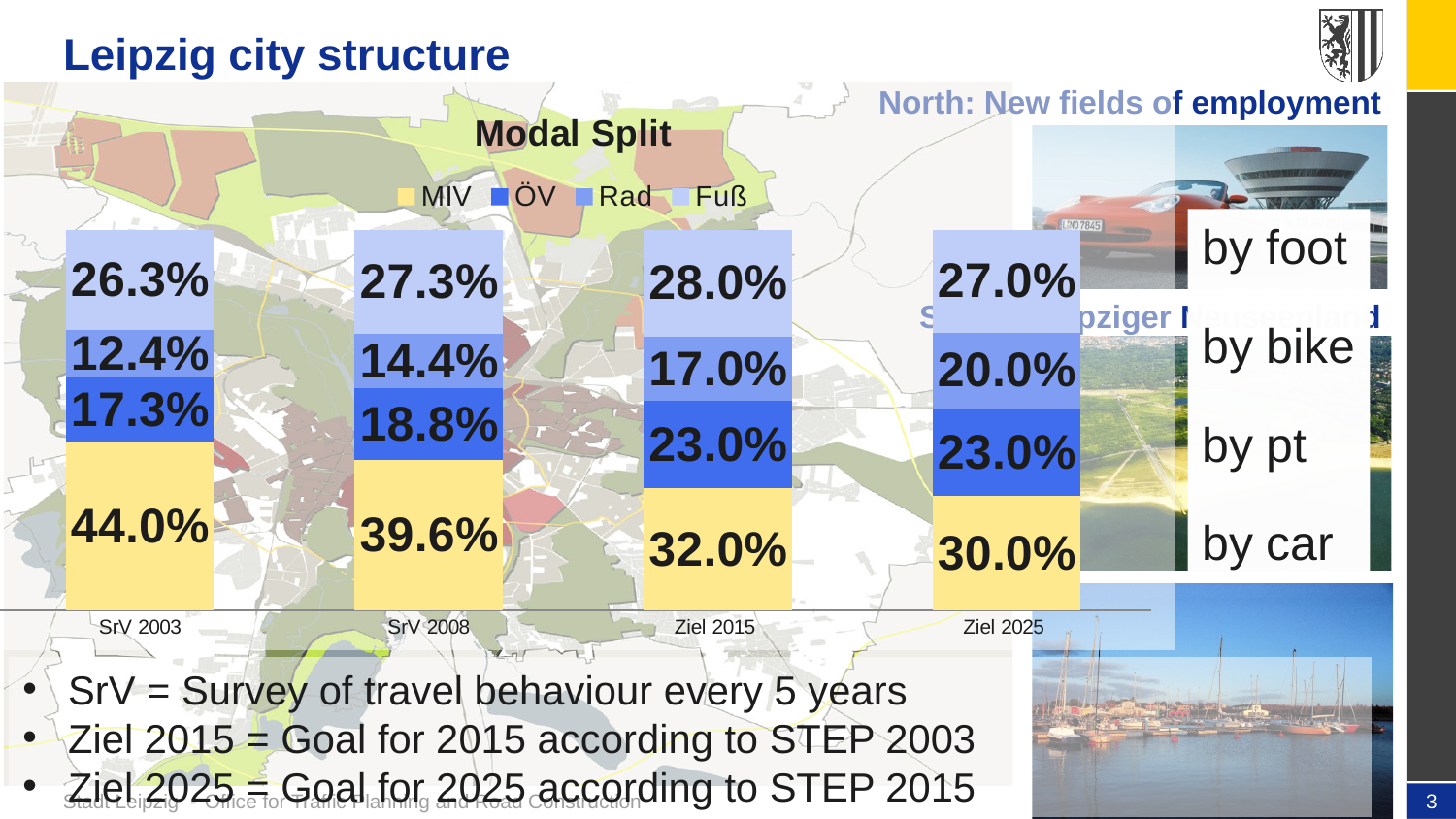
What is the ÖV share for SrV 2008 in the Modal Split chart? 18.8% What is the MIV share for SrV 2003 in the Modal Split chart? 44.0% What is the Fuß share for Ziel 2015 in the Modal Split chart? 28.0% In the Modal Split chart, which category has the lowest Rad share? SrV 2003 How many categories are shown on the x axis of the Modal Split chart? 4 What is the Rad share for Ziel 2025 in the Modal Split chart? 20.0% In the Modal Split chart, is the ÖV share larger for SrV 2008 or for Ziel 2015? Ziel 2015 In the Modal Split chart, what is the difference between the MIV share for SrV 2003 and for Ziel 2025? 14.0% What type of chart is the Modal Split chart? Stacked bar chart How many series does the legend of the Modal Split chart list? 4 In the Modal Split chart, does the MIV share rise or fall from SrV 2003 to Ziel 2025? Fall In the Modal Split chart, which category has the highest MIV share? SrV 2003